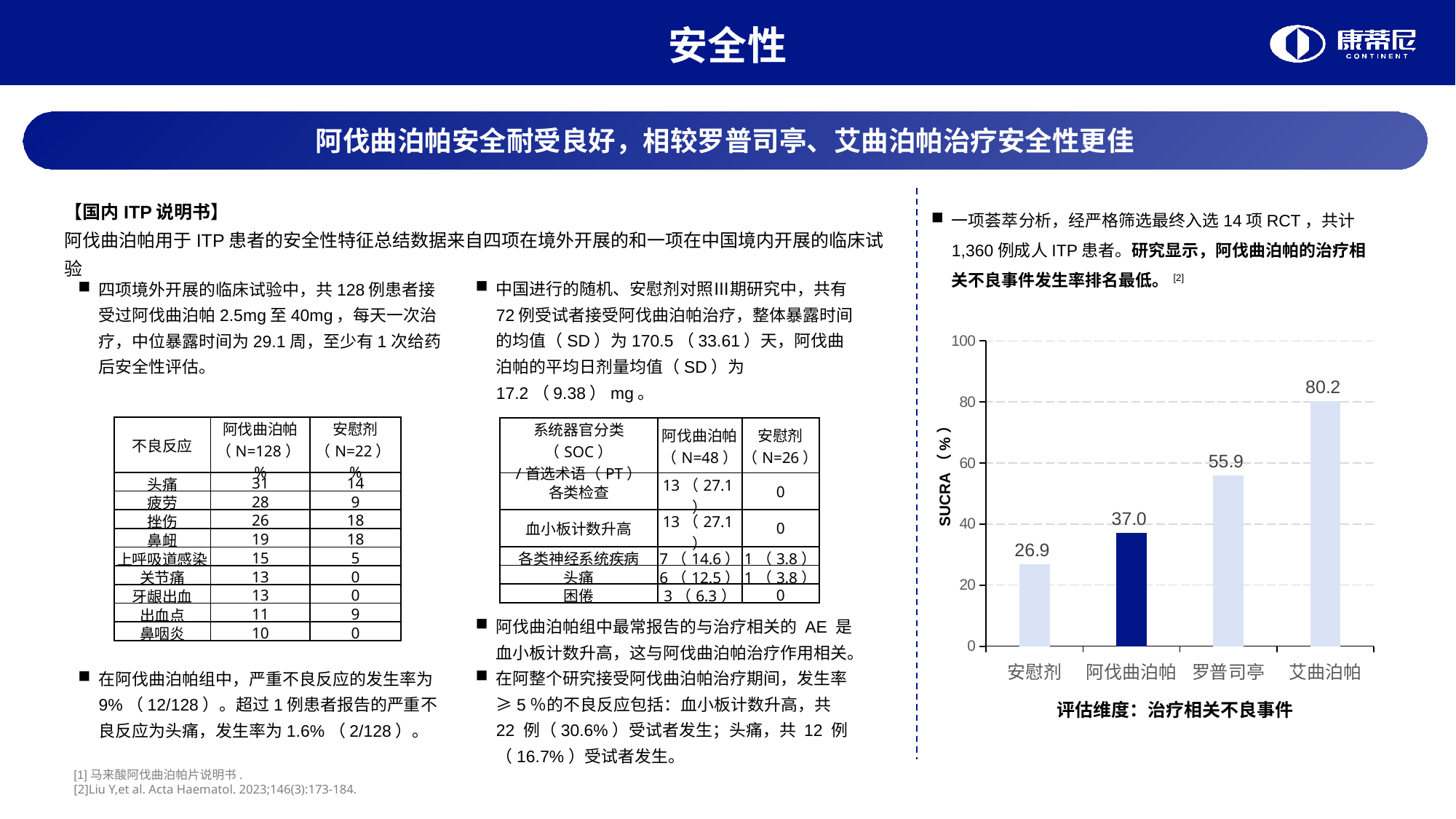
Which category has the lowest SUCRA (%) value in the bar chart? 安慰剂 What is the SUCRA (%) value for 罗普司亭 in the bar chart? 55.9 Is the SUCRA (%) value for 罗普司亭 greater or less than 60? less What is the SUCRA (%) value for 阿伐曲泊帕 in the bar chart? 37.0 How many categories are shown on the x axis of the bar chart? 4 What is the evaluation dimension (评估维度) stated below the bar chart? 治疗相关不良事件 Which category has the highest SUCRA (%) value in the bar chart? 艾曲泊帕 What is the SUCRA (%) value for 艾曲泊帕 in the bar chart? 80.2 Which has a larger SUCRA (%) value, 罗普司亭 or 阿伐曲泊帕? 罗普司亭 What is the SUCRA (%) value for 安慰剂 in the bar chart? 26.9 What type of chart is used to show the SUCRA (%) values? bar chart What is the difference between the SUCRA (%) values of 艾曲泊帕 and 阿伐曲泊帕? 43.2